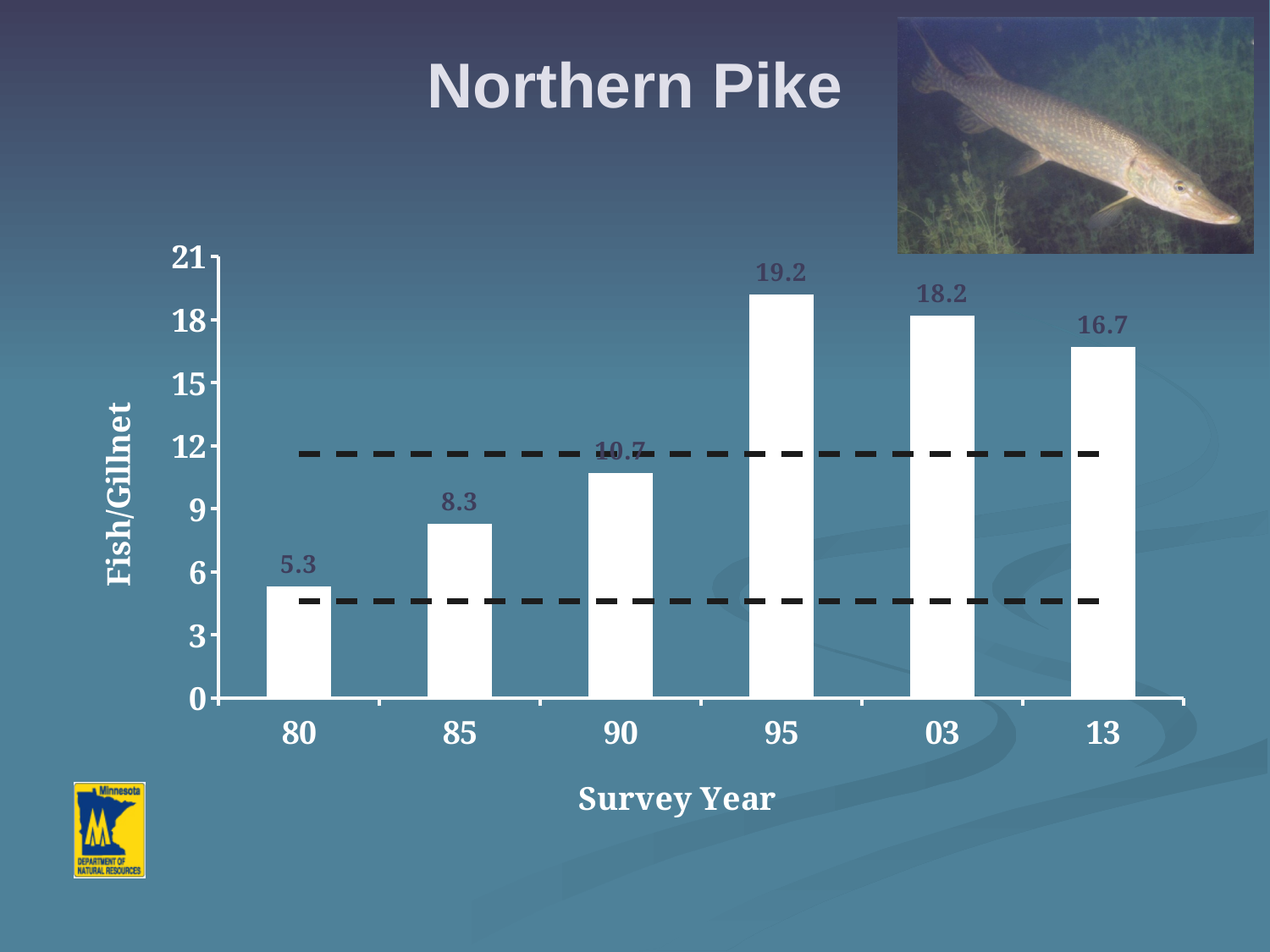
What is the difference between the Fish/Gillnet values for survey years 85 and 80? 3.0 Is the Fish/Gillnet value for survey year 85 greater or less than 9? less Which survey year has a larger Fish/Gillnet value, 90 or 03? 03 Which survey year has the lowest Fish/Gillnet value? 80 What kind of chart is shown on the slide? bar chart Which survey year has the highest Fish/Gillnet value? 95 How many survey years are shown on the chart? 6 What is the Fish/Gillnet value for survey year 95? 19.2 What is the Fish/Gillnet value for survey year 80? 5.3 What is the label of the y axis? Fish/Gillnet What is the difference between the Fish/Gillnet values for survey years 95 and 03? 1.0 What is the Fish/Gillnet value for survey year 13? 16.7